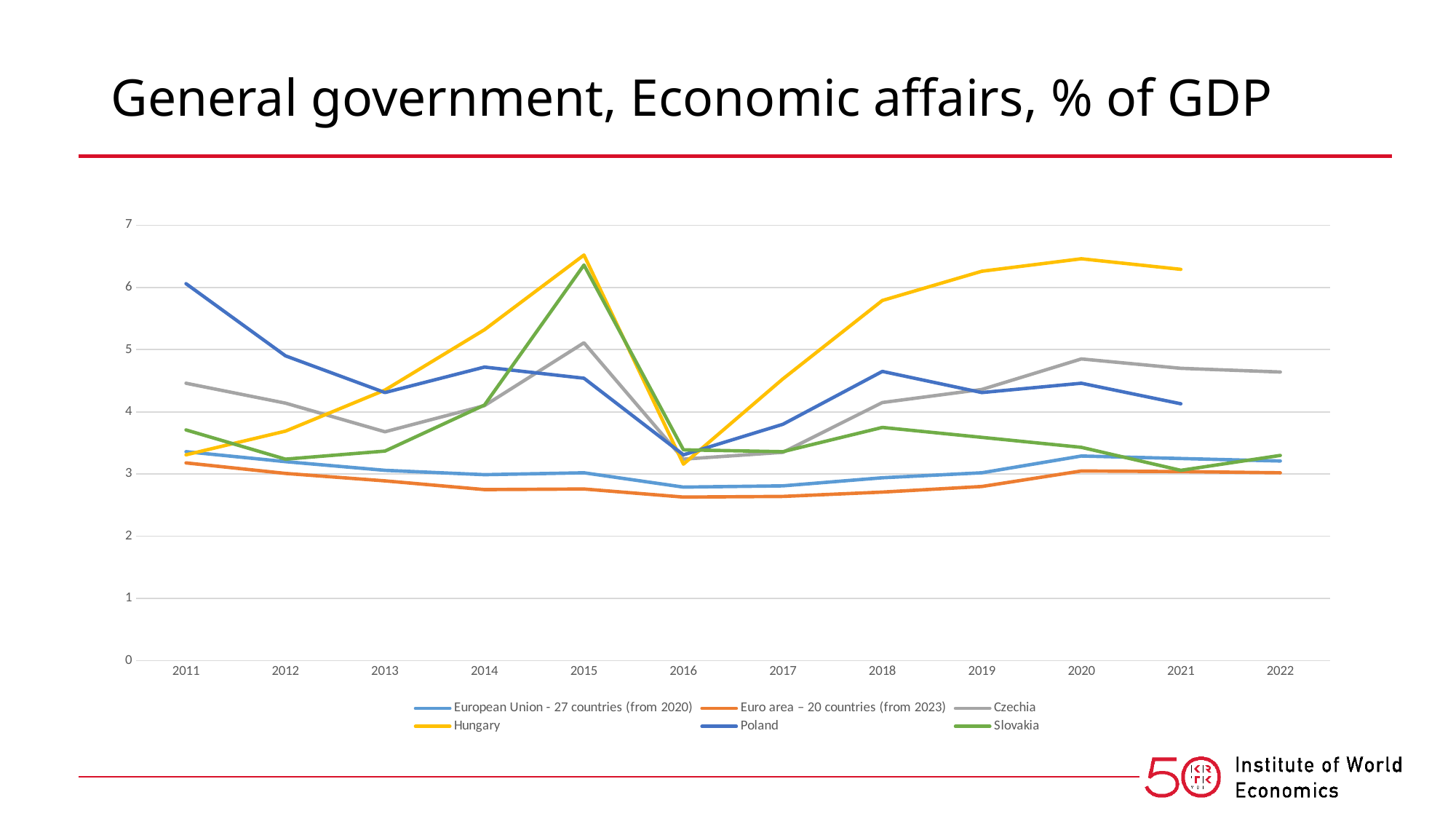
Which series has the highest value in 2020? Hungary Does the value for Hungary rise or fall from 2016 to 2020? rise Is the value for Euro area – 20 countries (from 2023) in 2016 greater or less than 3? less Is the value for Hungary in 2020 greater or less than 6? greater Is the value for Poland in 2011 greater or less than 5? greater What kind of chart is shown on the slide? line chart What is the title of the chart? General government, Economic affairs, % of GDP How many series does the legend list? 6 How many years are shown on the x axis? 12 In 2018, which is larger: the value for Hungary or the value for Poland? Hungary Which series has the highest value in 2011? Poland Which series has the lowest value in 2015? Euro area – 20 countries (from 2023)